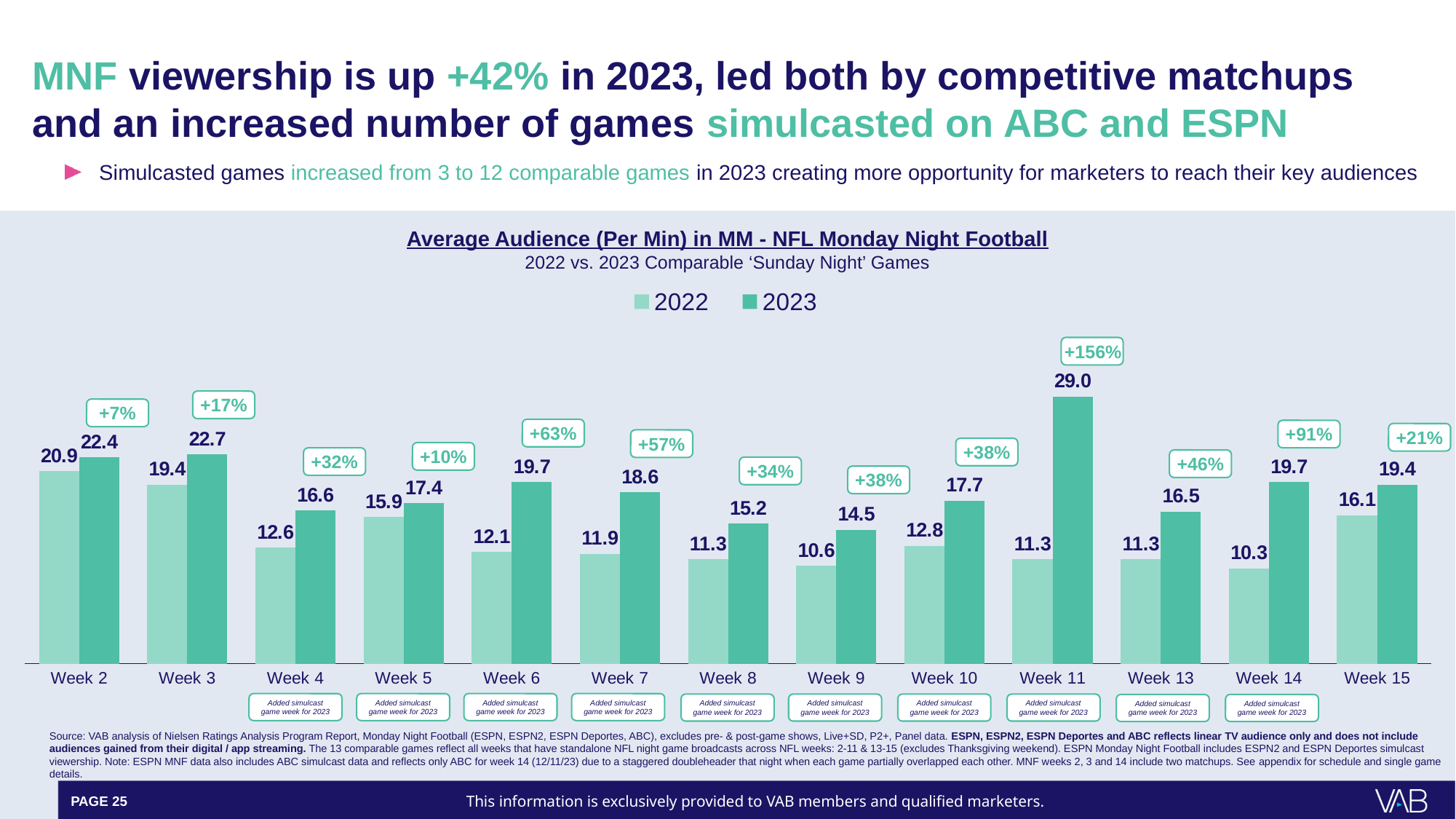
Which week has the highest 2022 average audience? Week 2 What kind of chart is shown on the slide? Bar chart What percentage change is shown above the Week 14 bars? +91% What is the difference between the 2023 and 2022 values for Week 11? 17.7 What was the 2023 average audience for Week 11? 29.0 How many series does the legend list? 2 What was the 2022 average audience for Week 5? 15.9 Which is larger: the 2023 value for Week 6 or the 2023 value for Week 7? Week 6 Which week has the highest 2023 average audience? Week 11 Which week has the lowest 2022 average audience? Week 14 What is the difference between the 2023 and 2022 values for Week 2? 1.5 How many weeks are shown on the x axis? 13